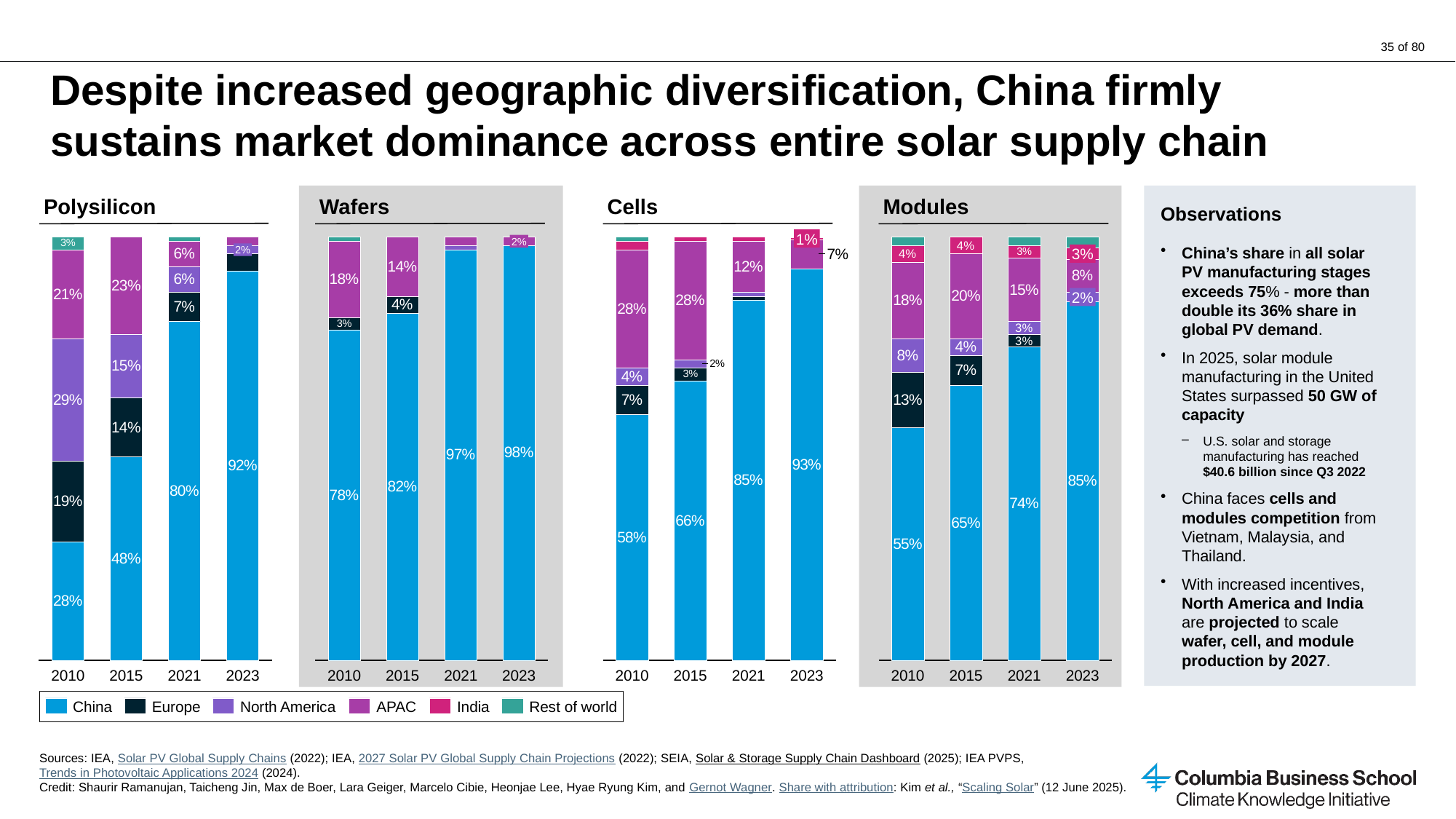
How many years are shown on the x axis of the Cells chart? 4 In the Wafers chart, what is China's share in 2023? 98% In the Modules chart, which is larger in 2015: APAC's share or Europe's share? APAC How many series does the legend list for the charts? 6 In the Cells chart, which year has the lowest China share? 2010 What kind of chart is the Polysilicon chart? Stacked bar chart In the Polysilicon chart, what is the difference between China's share in 2023 and in 2010? 64 percentage points In the Polysilicon chart, what is China's share in 2010? 28% In the Modules chart, which year has the highest China share? 2023 In the Cells chart, what is APAC's share in 2021? 12% In the Modules chart, what is Europe's share in 2010? 13% In the Polysilicon chart, does China's share rise or fall from 2010 to 2023? Rise